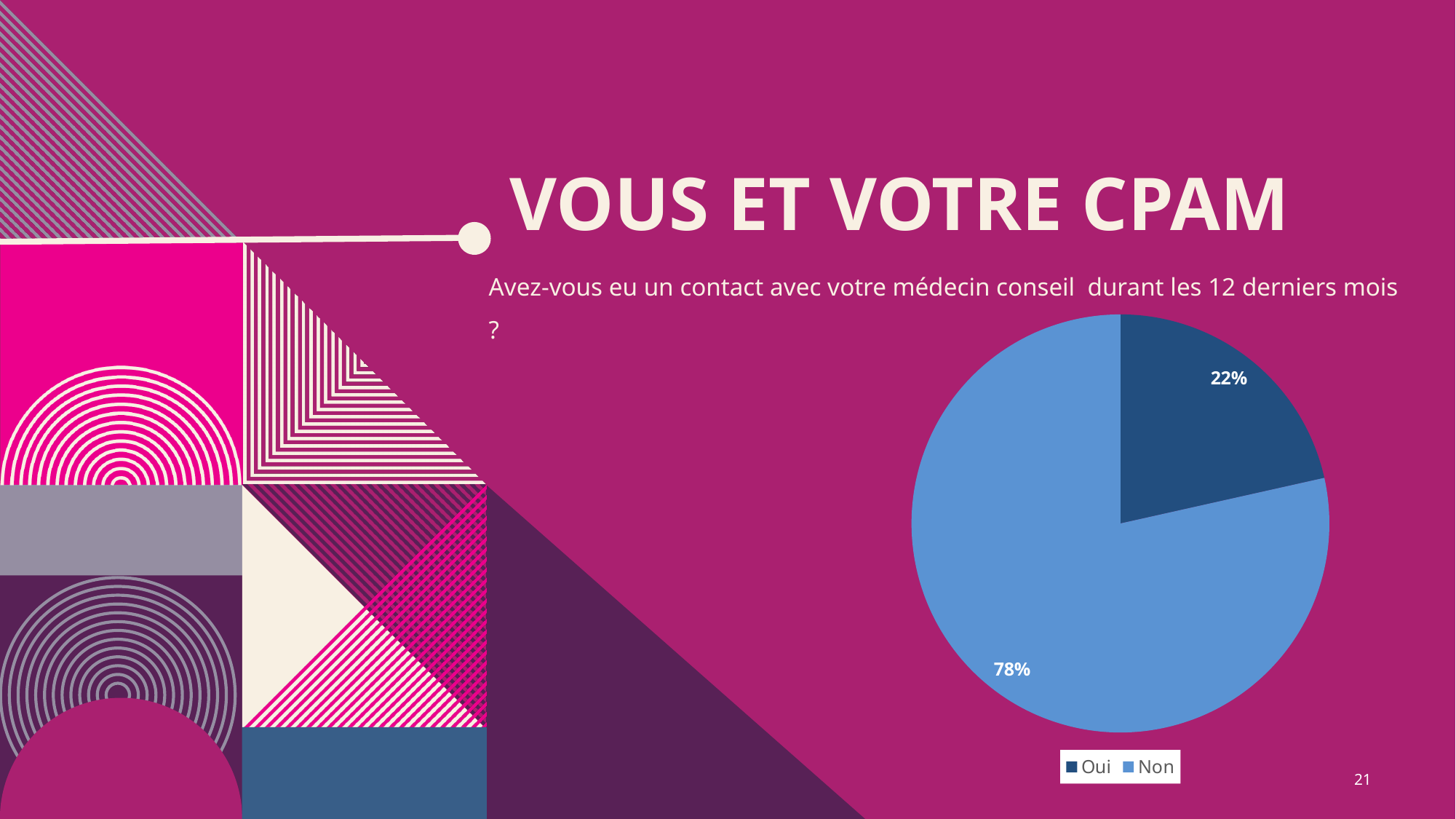
What kind of chart is shown on the slide? pie chart Which response has the smallest share of the pie? Oui How many slices does the pie chart have? 2 How many entries does the legend list? 2 What percentage of respondents answered "Oui"? 22% What percentage of respondents answered "Non"? 78% What share of the pie does the "Oui" slice represent? 22% What question does the pie chart answer, according to the text above it? Avez-vous eu un contact avec votre médecin conseil durant les 12 derniers mois ? Which response has the largest share of the pie? Non Which is larger, the share for "Oui" or the share for "Non"? Non What is the difference in percentage points between "Non" and "Oui"? 56 Which legend entry is shown in the darker blue colour? Oui